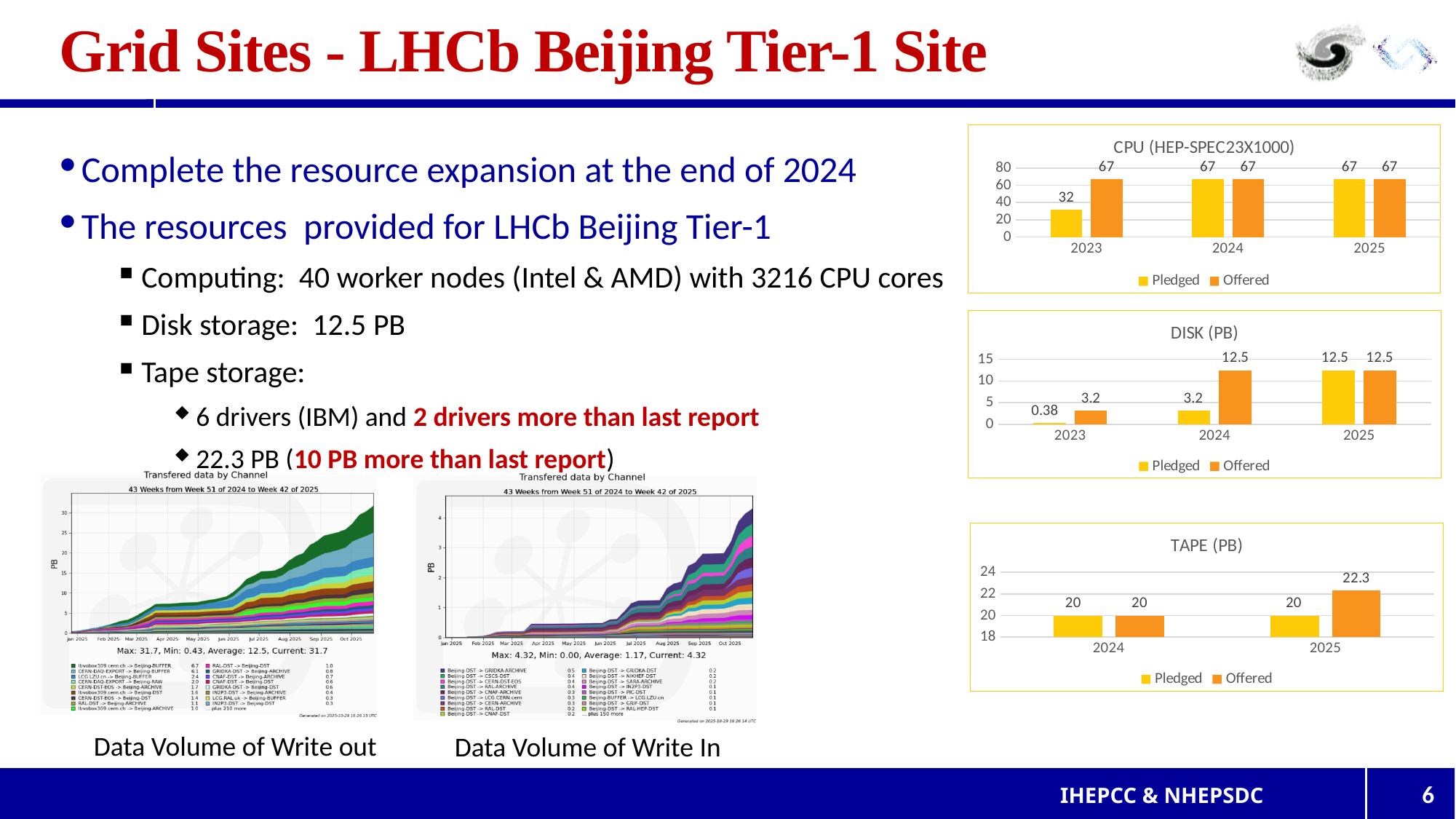
In the TAPE (PB) chart, what is the difference between the Offered and Pledged values for 2025? 2.3 How many years are shown on the x axis of the TAPE (PB) chart? 2 In the DISK (PB) chart, what is the Pledged value for 2023? 0.38 How many series does the legend of the CPU (HEP-SPEC23X1000) chart list? 2 In the DISK (PB) chart, what is the Offered value for 2024? 12.5 What kind of chart is the DISK (PB) chart? Bar chart In the DISK (PB) chart, is the Offered value for 2024 larger than the Pledged value for 2024? Yes In the CPU (HEP-SPEC23X1000) chart, what is the difference between the Offered and Pledged values for 2023? 35 In the CPU (HEP-SPEC23X1000) chart, what is the Offered value for 2024? 67 In the CPU (HEP-SPEC23X1000) chart, what is the Pledged value for 2023? 32 In the TAPE (PB) chart, what is the Offered value for 2025? 22.3 In the DISK (PB) chart, which year has the lowest Pledged value? 2023